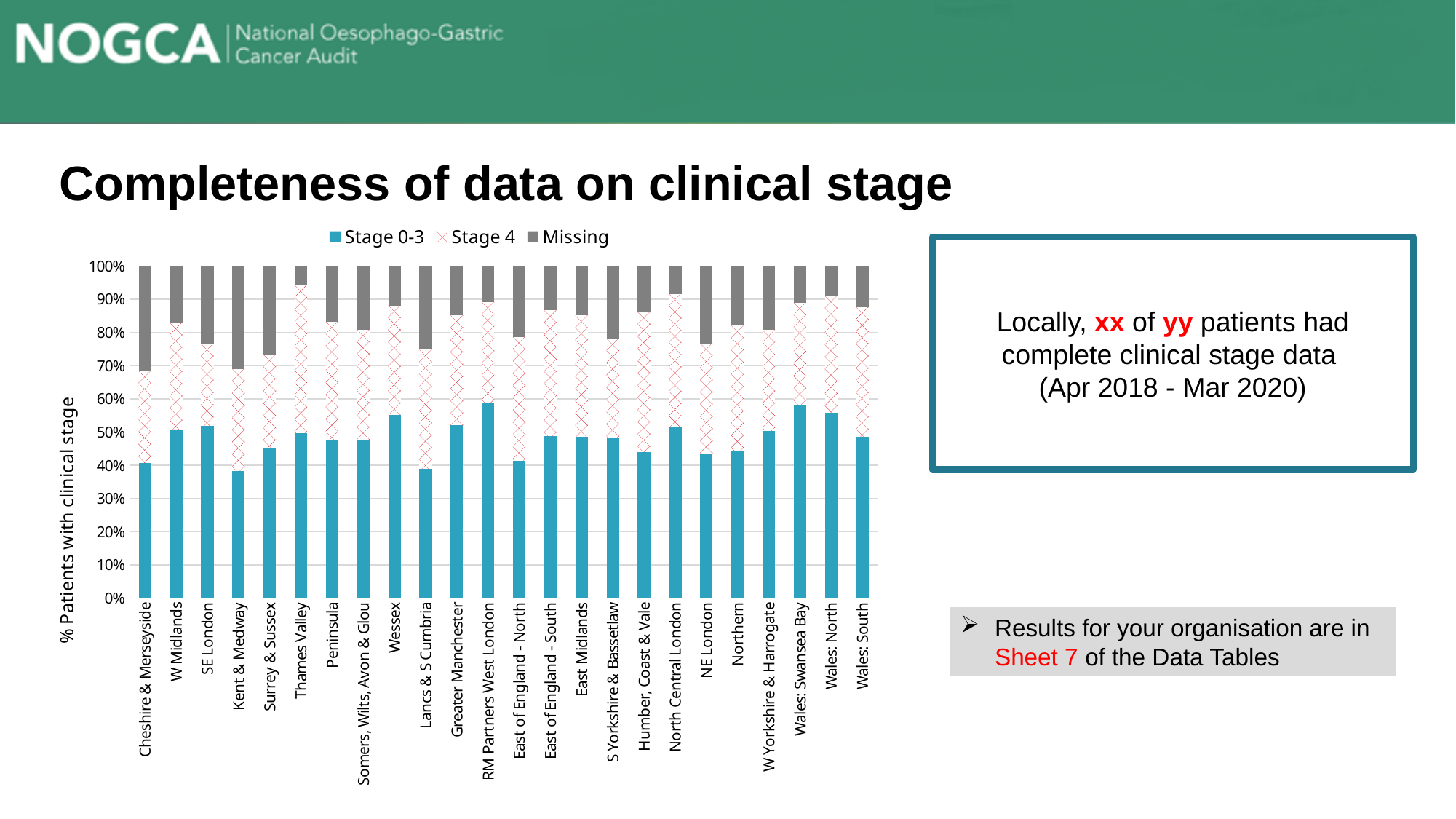
Is the Stage 0-3 value for RM Partners West London greater or less than 50%? greater How many regions (categories) are plotted along the x axis? 24 Is the Stage 0-3 value for Wessex greater or less than 50%? greater What do the three stacked segments of each bar add up to? 100% Is the Stage 0-3 value for Kent & Medway greater or less than 40%? less What is the label on the vertical axis? % Patients with clinical stage How many series does the chart legend list? 3 What kind of chart is shown on the slide? Stacked bar chart Which has the larger Missing share: Cheshire & Merseyside or Thames Valley? Cheshire & Merseyside What are the three series named in the legend? Stage 0-3, Stage 4, Missing Which has the larger Stage 0-3 share: Wessex or Kent & Medway? Wessex